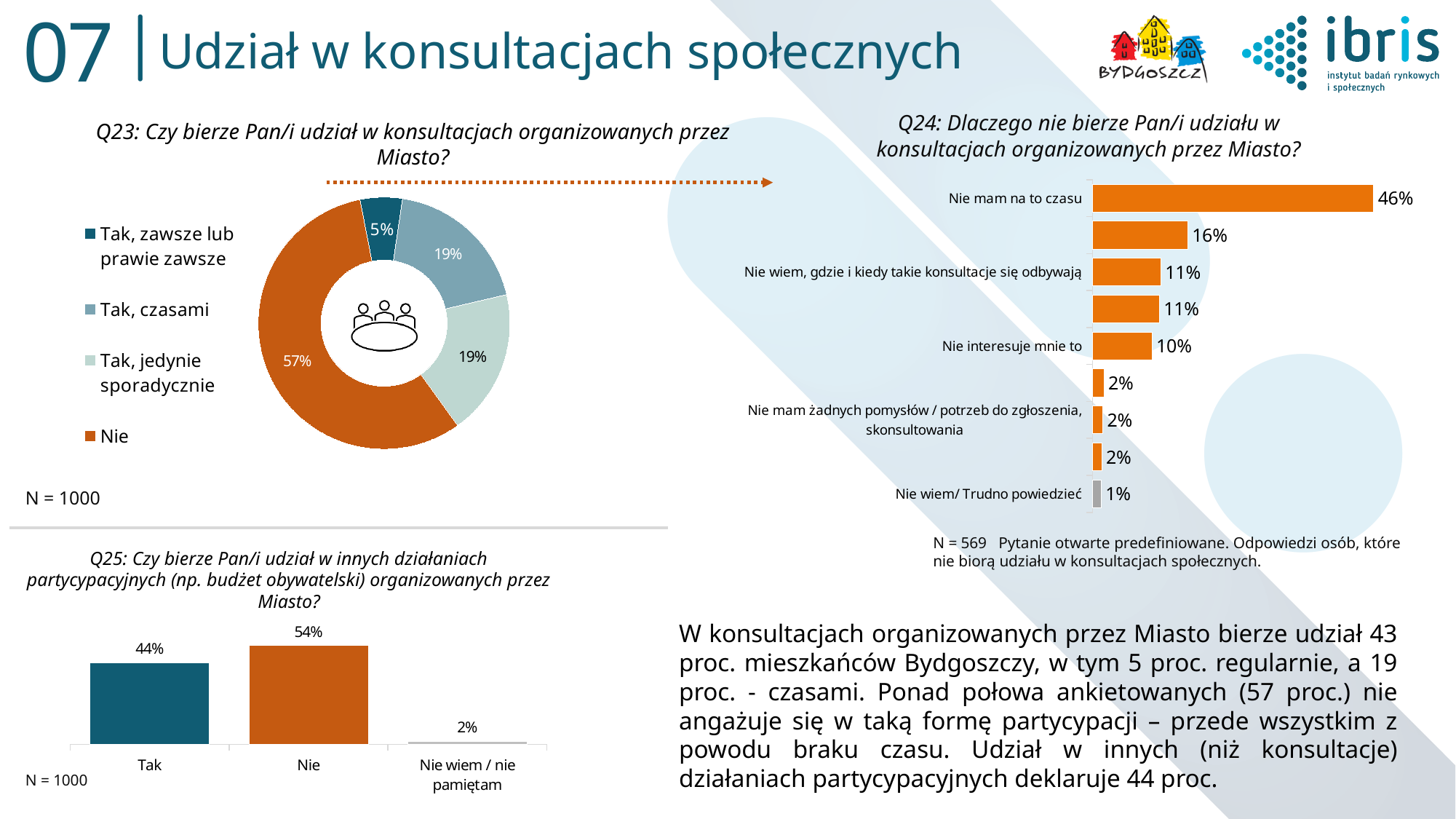
In the Q23 chart ("Czy bierze Pan/i udział w konsultacjach organizowanych przez Miasto?"), what share of respondents answered "Nie"? 57% How many bars are plotted in the Q24 chart? 9 In the Q25 chart, which is larger, "Tak" or "Nie"? Nie In the Q25 chart ("Czy bierze Pan/i udział w innych działaniach partycypacyjnych..."), what is the value for "Tak"? 44% In the Q24 chart, what is the difference between "Nie mam na to czasu" and "Nie wiem, gdzie i kiedy takie konsultacje się odbywają"? 35 percentage points What kind of chart is used for Q23? Pie (donut) chart How many entries does the legend of the Q23 chart list? 4 In the Q23 chart, which answer has the smallest share? Tak, zawsze lub prawie zawsze In the Q23 chart, which answer has the largest share? Nie In the Q23 donut chart, what percentage answered "Tak, zawsze lub prawie zawsze"? 5% In the Q24 chart, what is the value for "Nie interesuje mnie to"? 10% In the Q24 chart ("Dlaczego nie bierze Pan/i udziału w konsultacjach..."), what is the value for "Nie mam na to czasu"? 46%